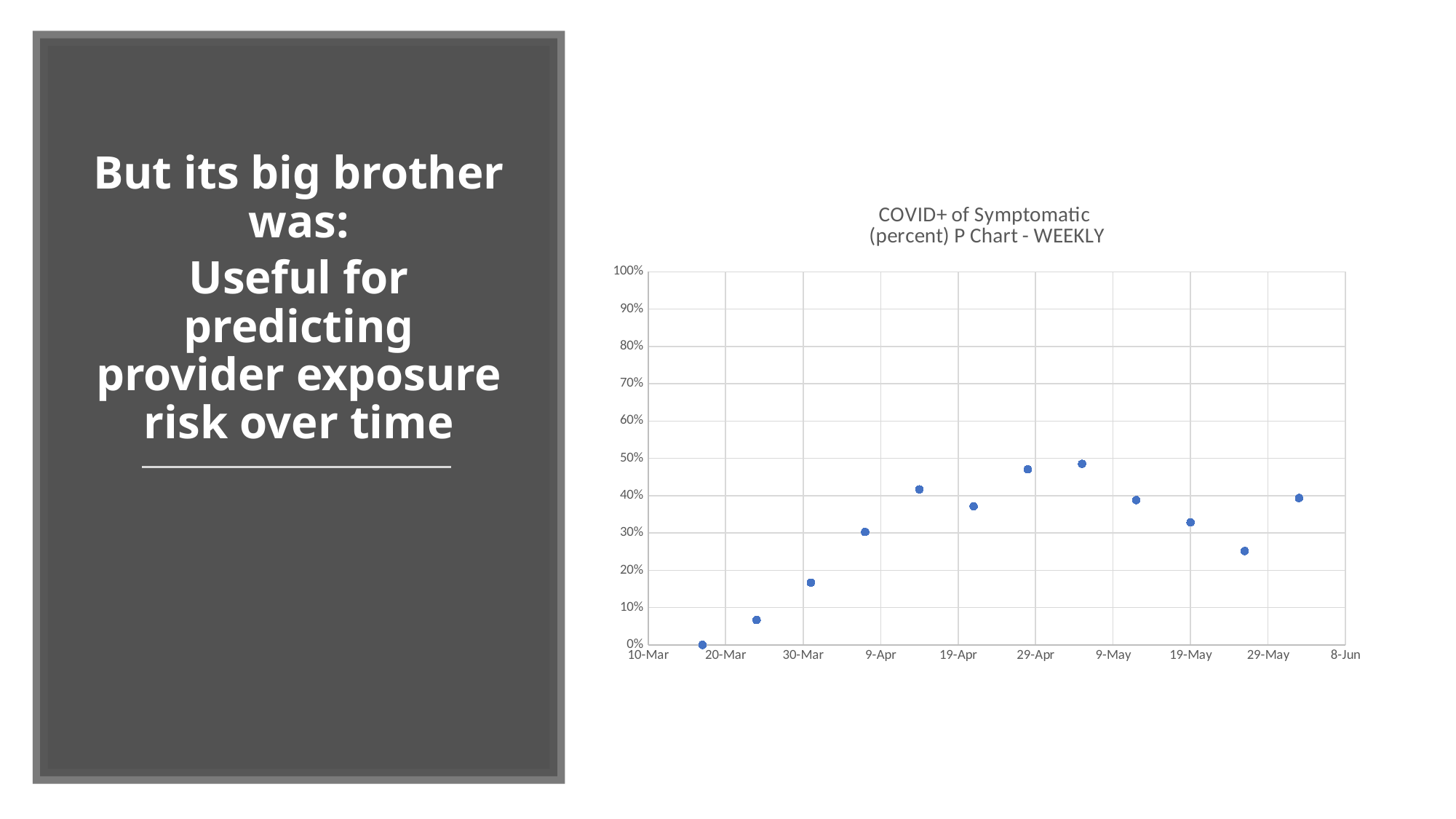
Is the value of the last (latest) point greater or less than 30%? greater Is the value of the first (earliest) point greater or less than 10%? less Do the values rise or fall across the first four points on the chart? rise Is the value of the point nearest 9-Apr greater or less than 40%? less Which is larger, the value of the first point or the value of the last point? the last point What kind of chart is shown on the slide? scatter chart What is the highest value shown on the y axis? 100% What is the title of the chart? COVID+ of Symptomatic (percent) P Chart - WEEKLY How many data points are plotted on the chart? 12